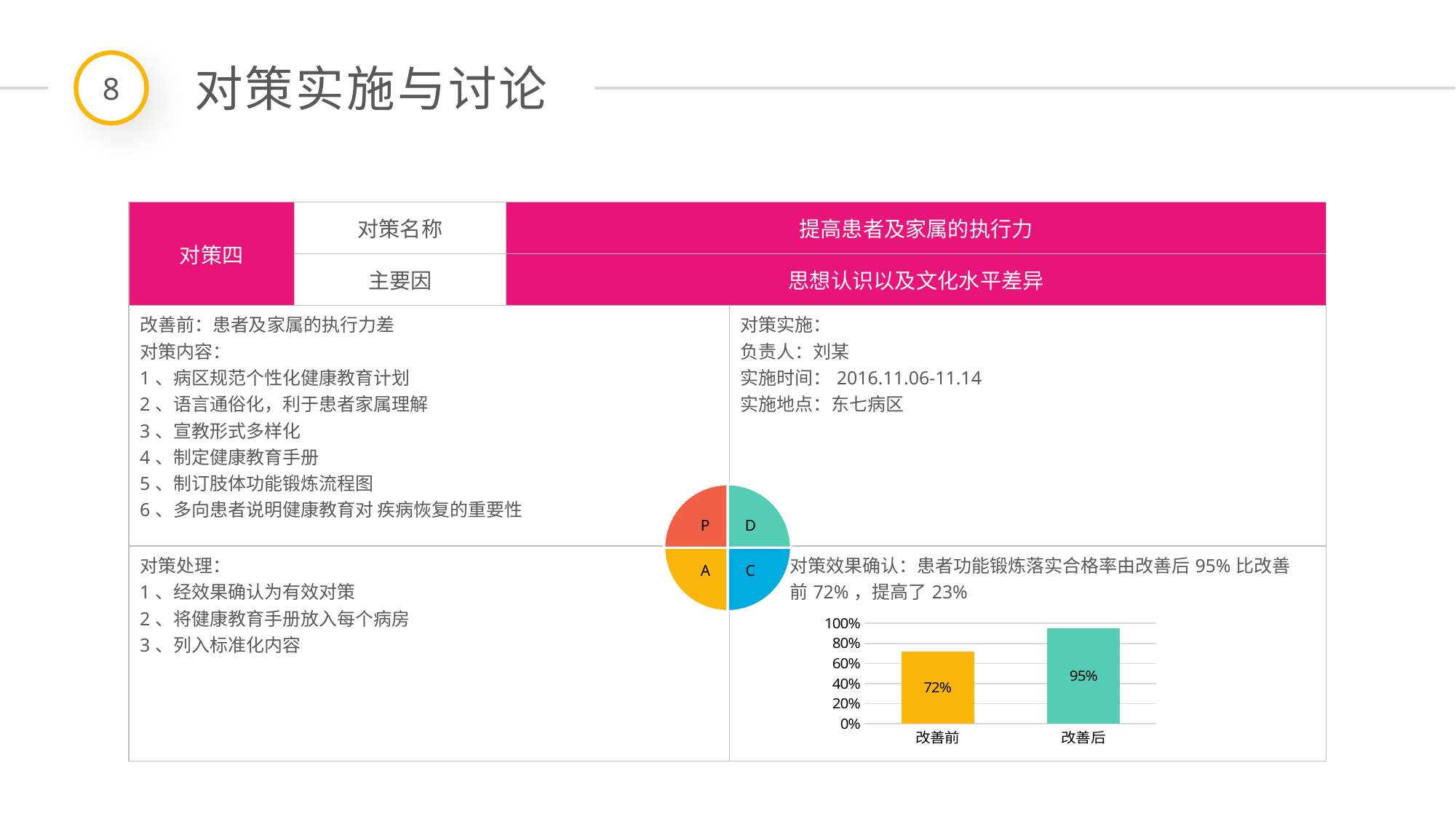
What is the difference between the 改善后 and 改善前 values in the bar chart? 23% What is the value for 改善后 in the bar chart? 95% Which category has the lower value in the bar chart? 改善前 Is the value for 改善前 larger or smaller than the value for 改善后? smaller How many categories are shown in the bar chart? 2 What is the maximum value shown on the y axis of the bar chart? 100% What kind of chart is used to show the 改善前 and 改善后 values? bar chart What is the value for 改善前 in the bar chart? 72% Is the value for 改善后 greater or less than 80%? greater Is the value for 改善前 greater or less than 80%? less Do the values rise or fall from 改善前 to 改善后 in the bar chart? rise Which category has the higher value in the bar chart? 改善后